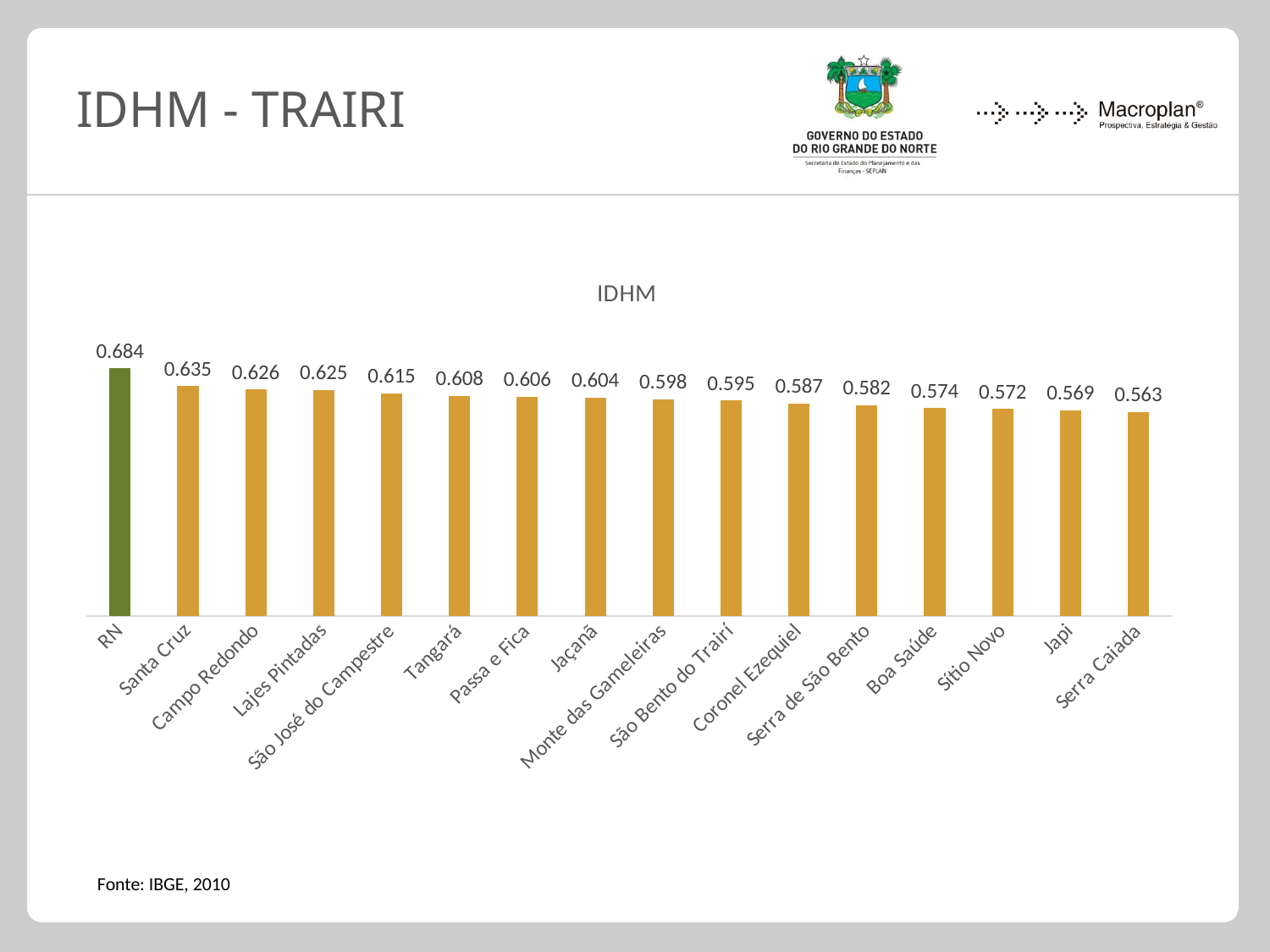
What kind of chart is shown on the slide? Bar chart What is the IDHM value for Monte das Gameleiras? 0.598 What is the IDHM value for Tangará? 0.608 What is the difference between the IDHM of Coronel Ezequiel and Japi? 0.018 Which category has the highest IDHM value? RN What is the difference between the IDHM of RN and Santa Cruz? 0.049 Which has a higher IDHM, Campo Redondo or Boa Saúde? Campo Redondo Which category has the lowest IDHM value? Serra Caiada How many categories are shown on the x axis of the chart? 16 Do the IDHM values rise or fall from left to right along the x axis? Fall What is the IDHM value for Santa Cruz? 0.635 What is the IDHM value for Serra Caiada? 0.563